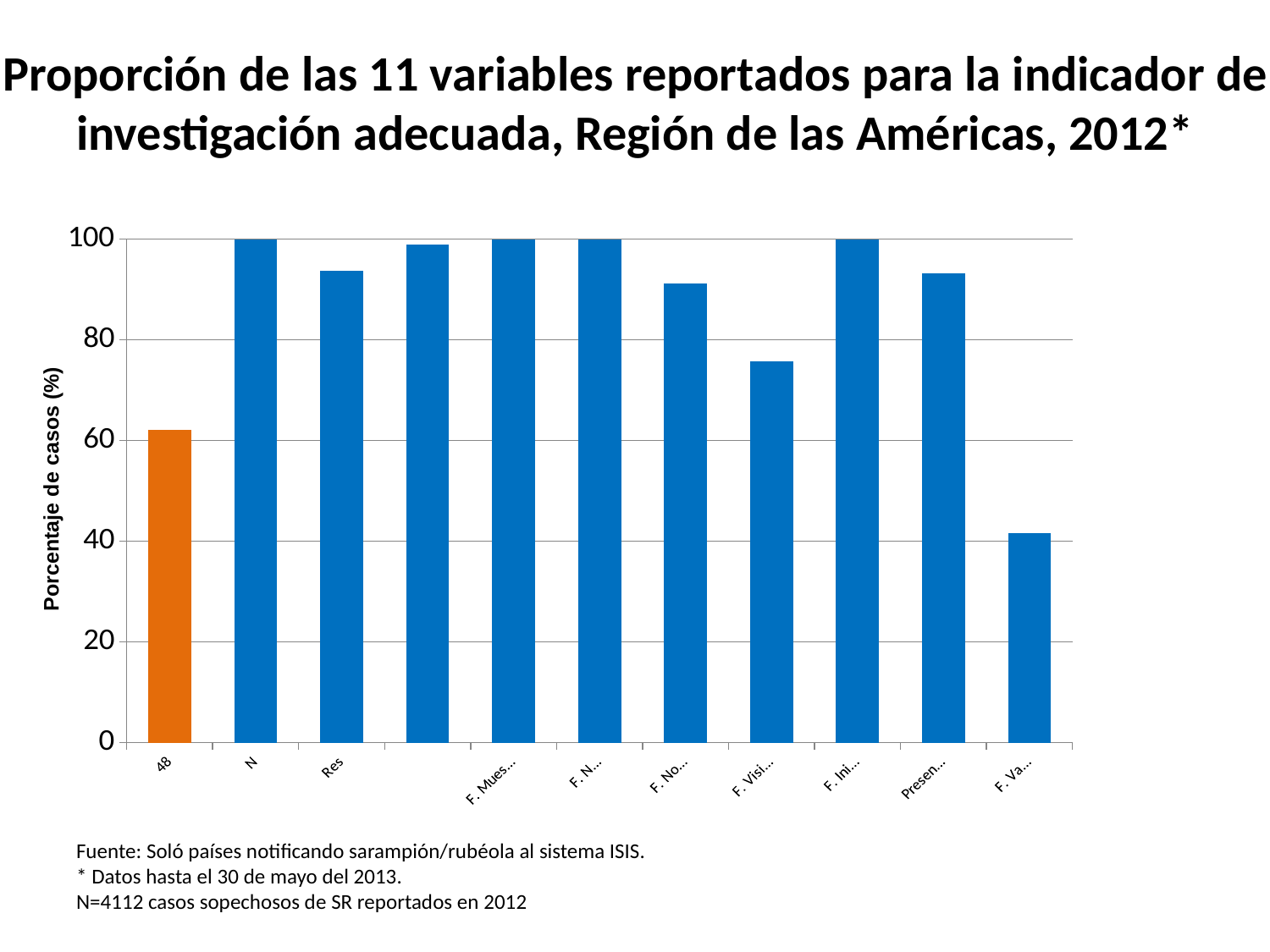
Is the value for the bar labelled "48" greater or less than 40? greater What kind of chart is shown on the slide? bar chart Is the value for "Res" greater or less than 80? greater Is the value for "F. Va..." greater or less than 60? less What is the label of the vertical axis? Porcentaje de casos (%) Which has the larger value, "Res" or the bar labelled "48"? Res What colour is the bar labelled "48"? orange How many bars are plotted in the chart? 11 Which bar has the lowest value in the chart? F. Va... Which has the larger value, the bar labelled "48" or the bar labelled "N"? N